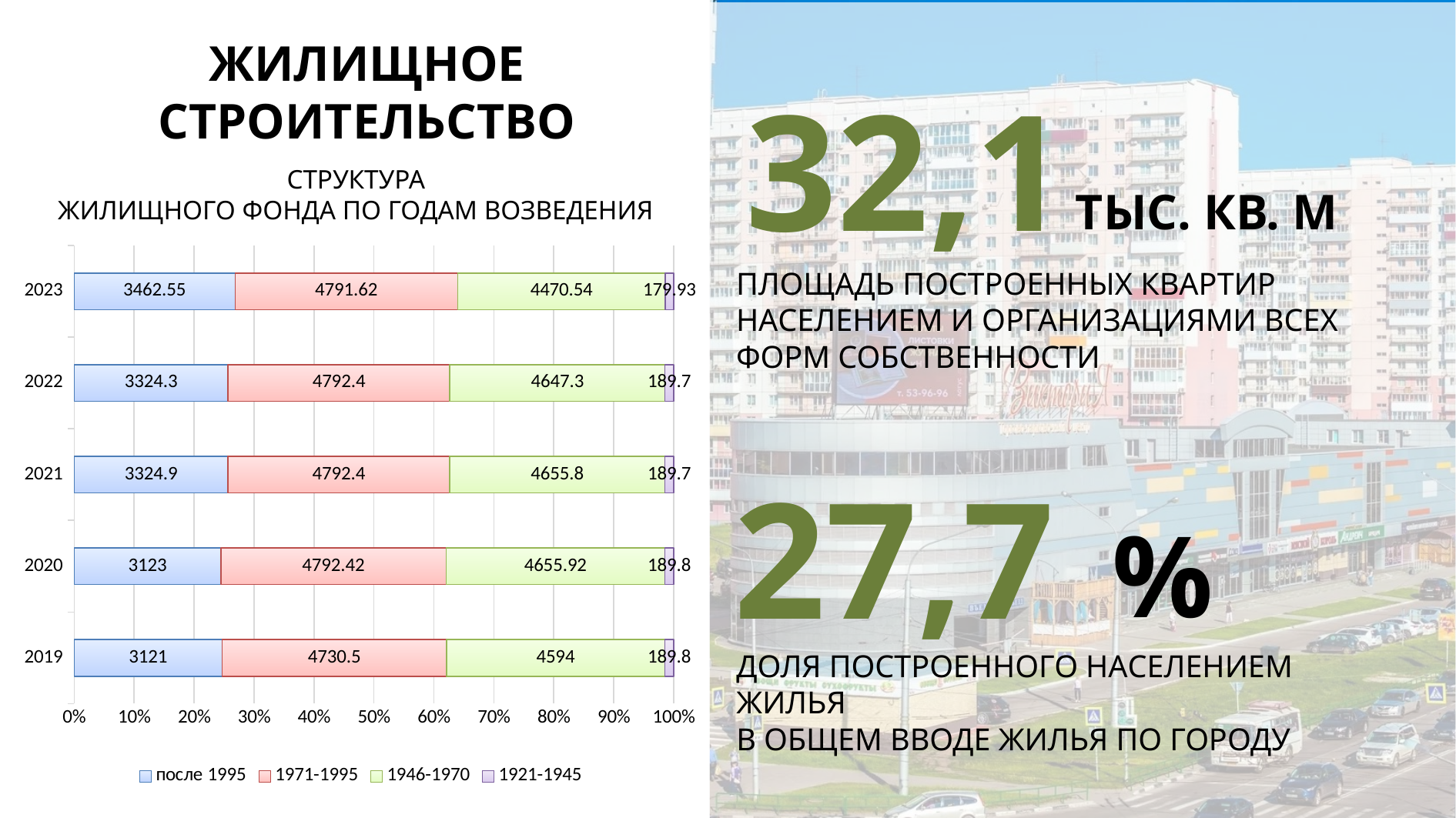
What kind of chart is shown on the slide? Stacked bar chart How many years are shown on the chart? 5 In which year is the 'после 1995' value the highest? 2023 What is the value for the '1946-1970' series in 2019? 4594 What is the value for the 'после 1995' series in 2023? 3462.55 How many series does the legend list? 4 What is the value for the '1971-1995' series in 2020? 4792.42 In which year is the '1921-1945' value the lowest? 2023 What is the total of the stacked bar for 2019? 12635.3 What is the difference between the 'после 1995' values for 2023 and 2019? 341.55 Which is larger in 2023: the '1971-1995' value or the '1946-1970' value? 1971-1995 What is the value for the '1921-1945' series in 2022? 189.7